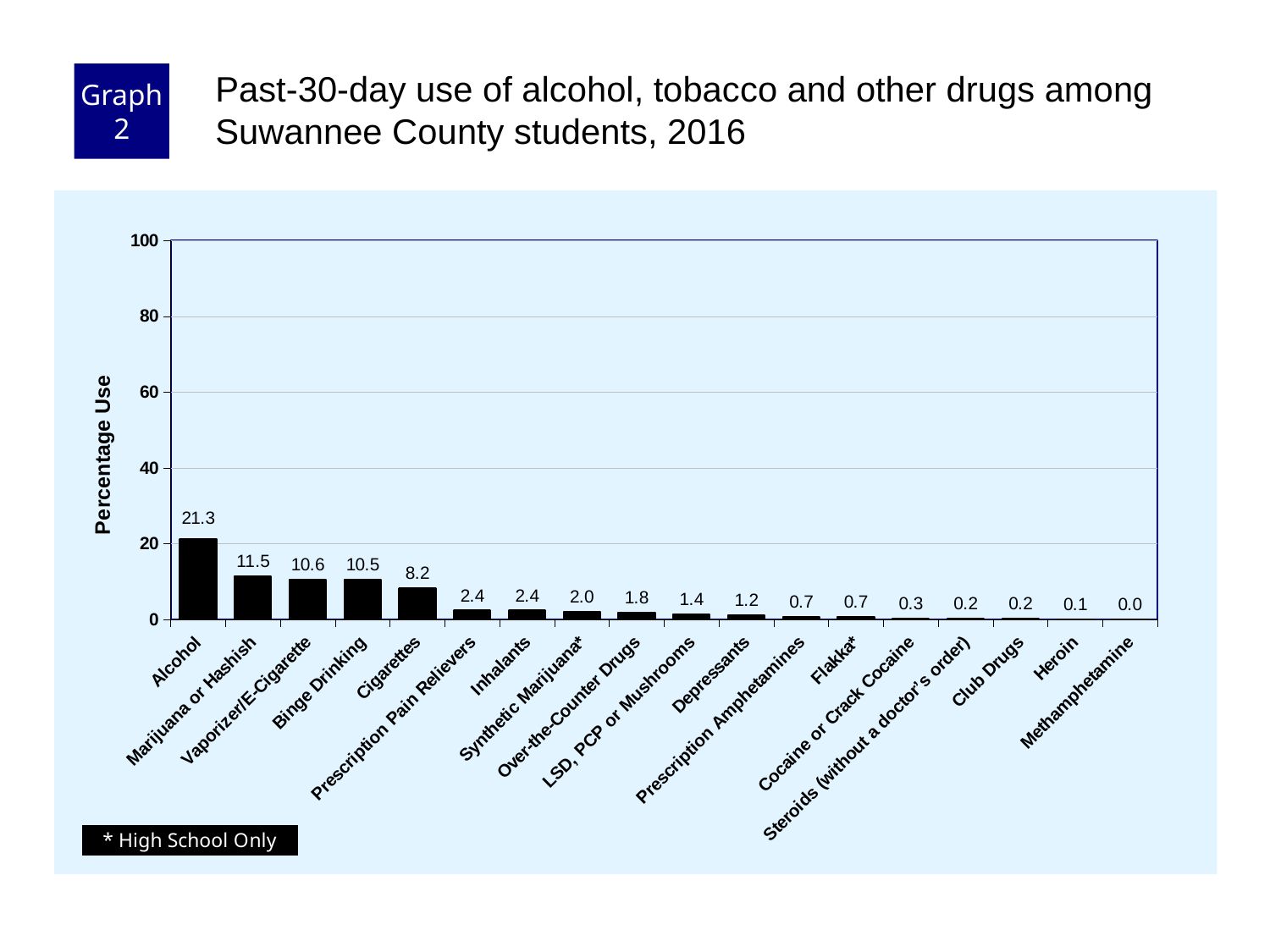
What is the percentage use for Heroin? 0.1 Is the value for Alcohol greater or less than 20? greater What is the label of the y axis? Percentage Use What is the percentage use for Cigarettes? 8.2 What is the percentage use for Vaporizer/E-Cigarette? 10.6 Which category has the lowest percentage use? Methamphetamine What is the percentage use for Alcohol? 21.3 Which category has the highest percentage use? Alcohol How many categories are shown on the x axis? 18 What is the difference in percentage use between Alcohol and Marijuana or Hashish? 9.8 What kind of chart is shown on the slide? bar chart Which has a higher percentage use, Binge Drinking or Cigarettes? Binge Drinking